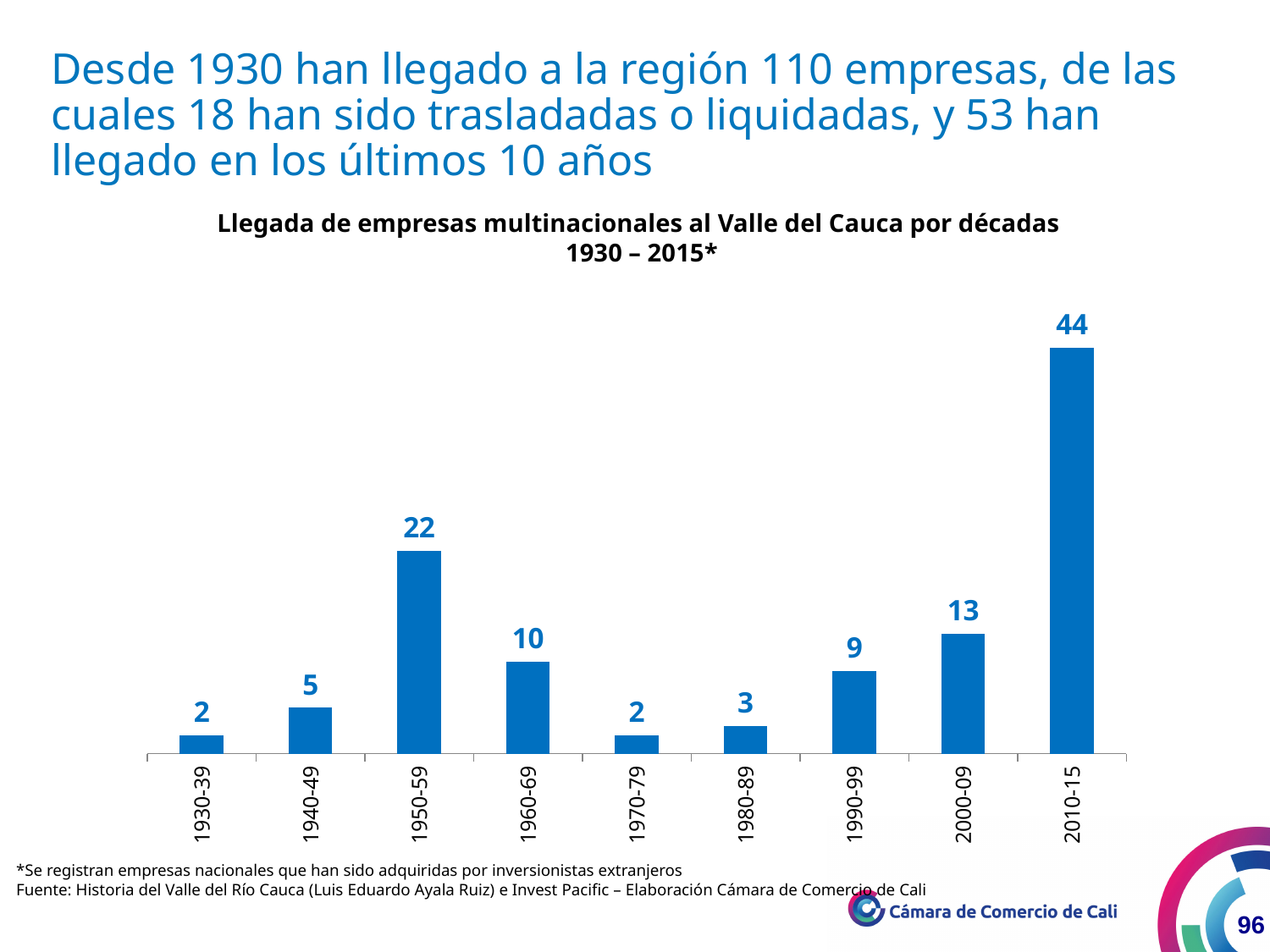
What is the difference between the values for 1960-69 and 1940-49? 5 Do the values rise or fall from 1970-79 to 2010-15? Rise What is the title of the chart? Llegada de empresas multinacionales al Valle del Cauca por décadas 1930 – 2015* Which is larger, the value for 1990-99 or the value for 2000-09? 2000-09 How many decade categories are shown on the x axis? 9 What is the difference between the values for 2010-15 and 1950-59? 22 What is the value for 1950-59? 22 What kind of chart is shown on the slide? Bar chart What is the value for 2000-09? 13 What is the value for 1980-89? 3 Which decade has the highest value? 2010-15 Which decades share the lowest value? 1930-39 and 1970-79